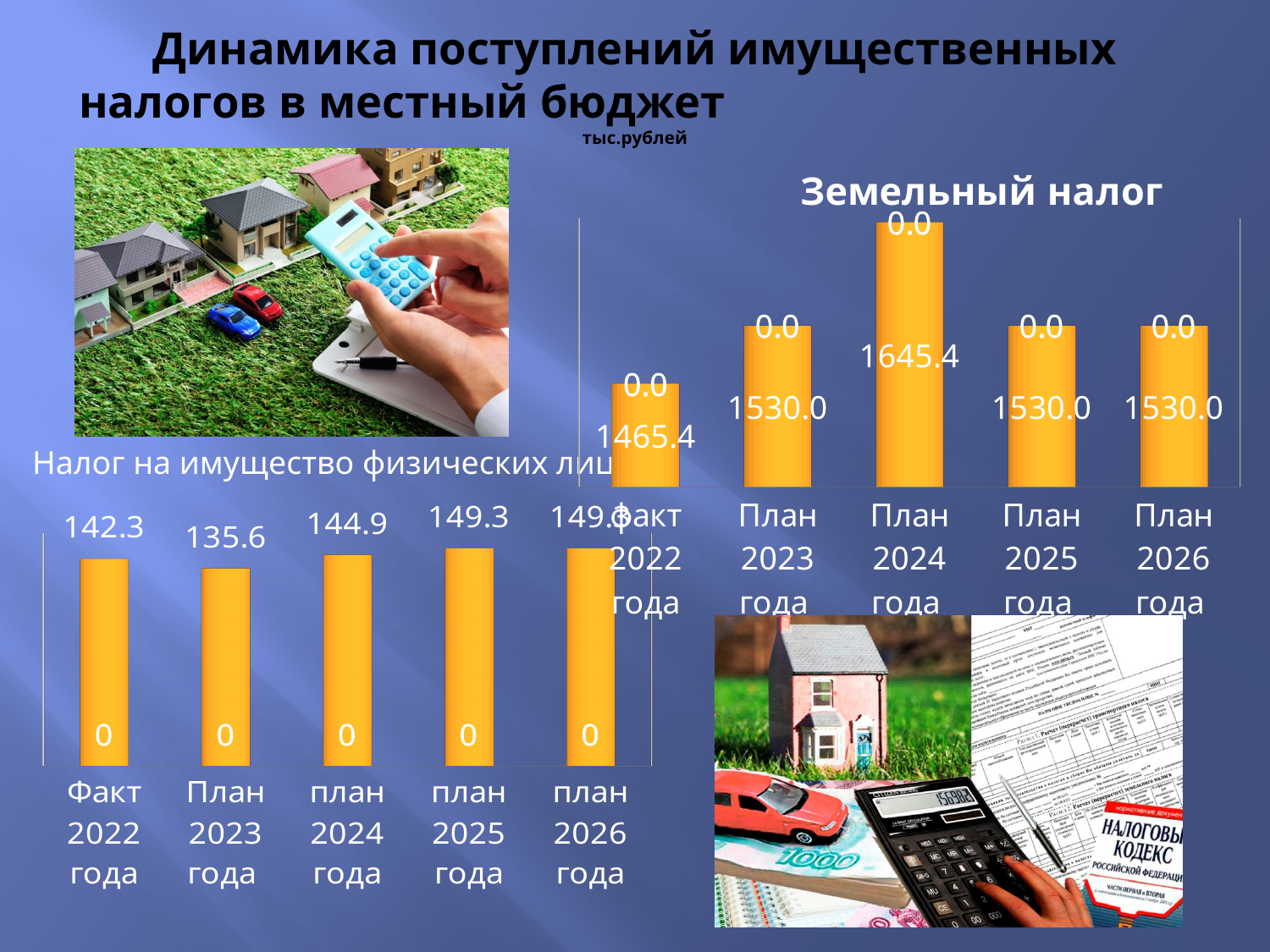
What type of chart is the Земельный налог chart? Bar chart On the Земельный налог chart, which category has the lowest value? Факт 2022 года On the Земельный налог chart, what is the value for План 2024 года? 1645.4 On the Земельный налог chart, which category has the highest value? План 2024 года On the Земельный налог chart, what is the value for Факт 2022 года? 1465.4 On the Налог на имущество физических лиц chart, what is the value for План 2023 года? 135.6 How many categories are shown on the Земельный налог chart? 5 On the Налог на имущество физических лиц chart, which is larger: the value for план 2024 года or for Факт 2022 года? план 2024 года On the Налог на имущество физических лиц chart, which category has the lowest value? План 2023 года On the Земельный налог chart, what is the difference between the values for План 2024 года and План 2023 года? 115.4 On the Налог на имущество физических лиц chart, what is the difference between the values for Факт 2022 года and План 2023 года? 6.7 In what units are the values on the slide's charts given? тыс.рублей